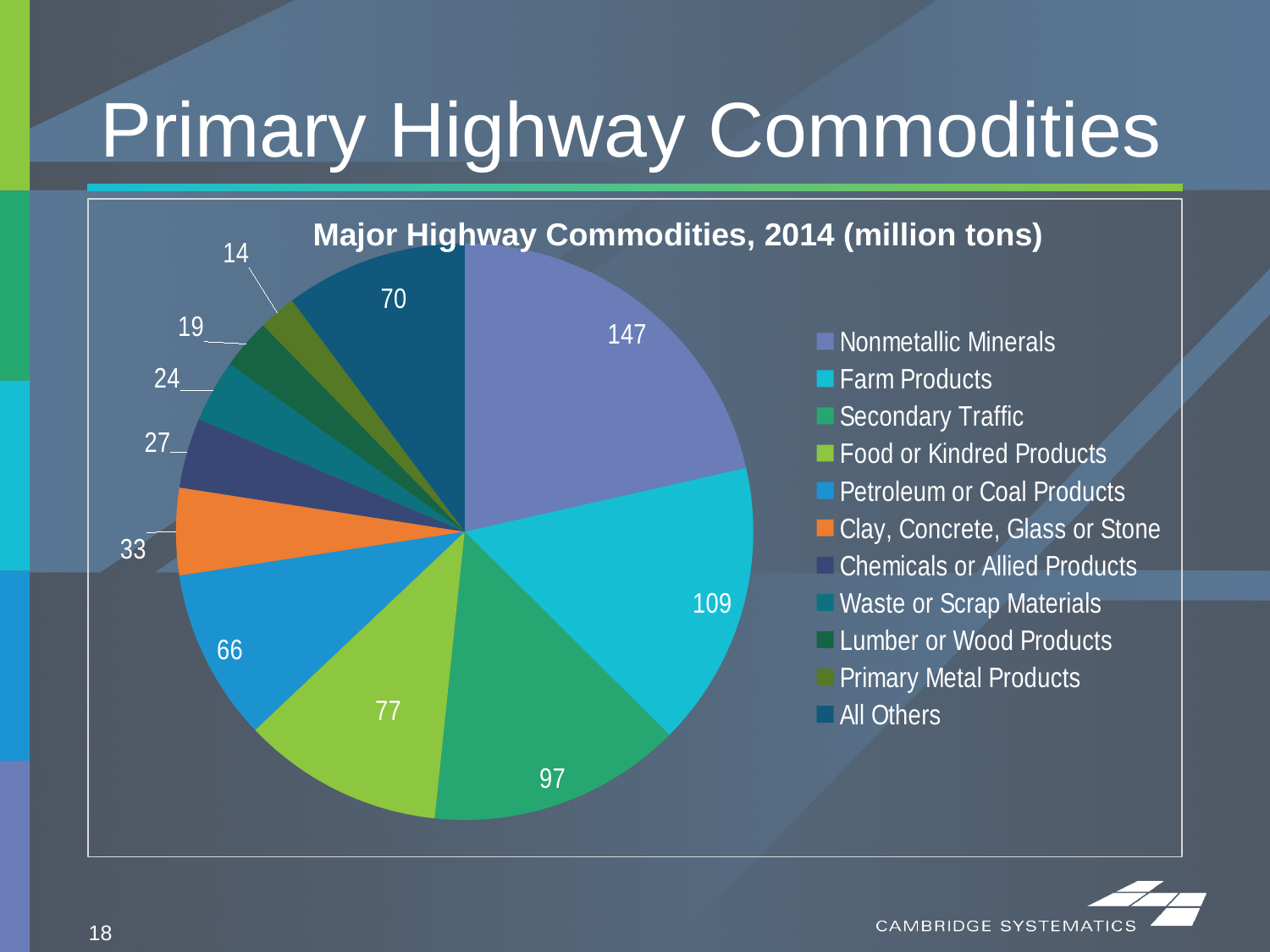
What is the value for Primary Metal Products in the pie chart? 14 Which is larger, Secondary Traffic or Food or Kindred Products? Secondary Traffic How many categories are shown in the pie chart? 11 What is the value for Petroleum or Coal Products in the pie chart? 66 Which commodity category has the largest slice in the pie chart? Nonmetallic Minerals Which commodity category has the smallest slice in the pie chart? Primary Metal Products What is the value for Nonmetallic Minerals in the Major Highway Commodities pie chart? 147 What is the value for All Others in the pie chart? 70 What type of chart is shown on the slide? Pie chart What is the difference between the values for Nonmetallic Minerals and Farm Products? 38 What is the title of the pie chart? Major Highway Commodities, 2014 (million tons) What is the value for Farm Products in the pie chart? 109